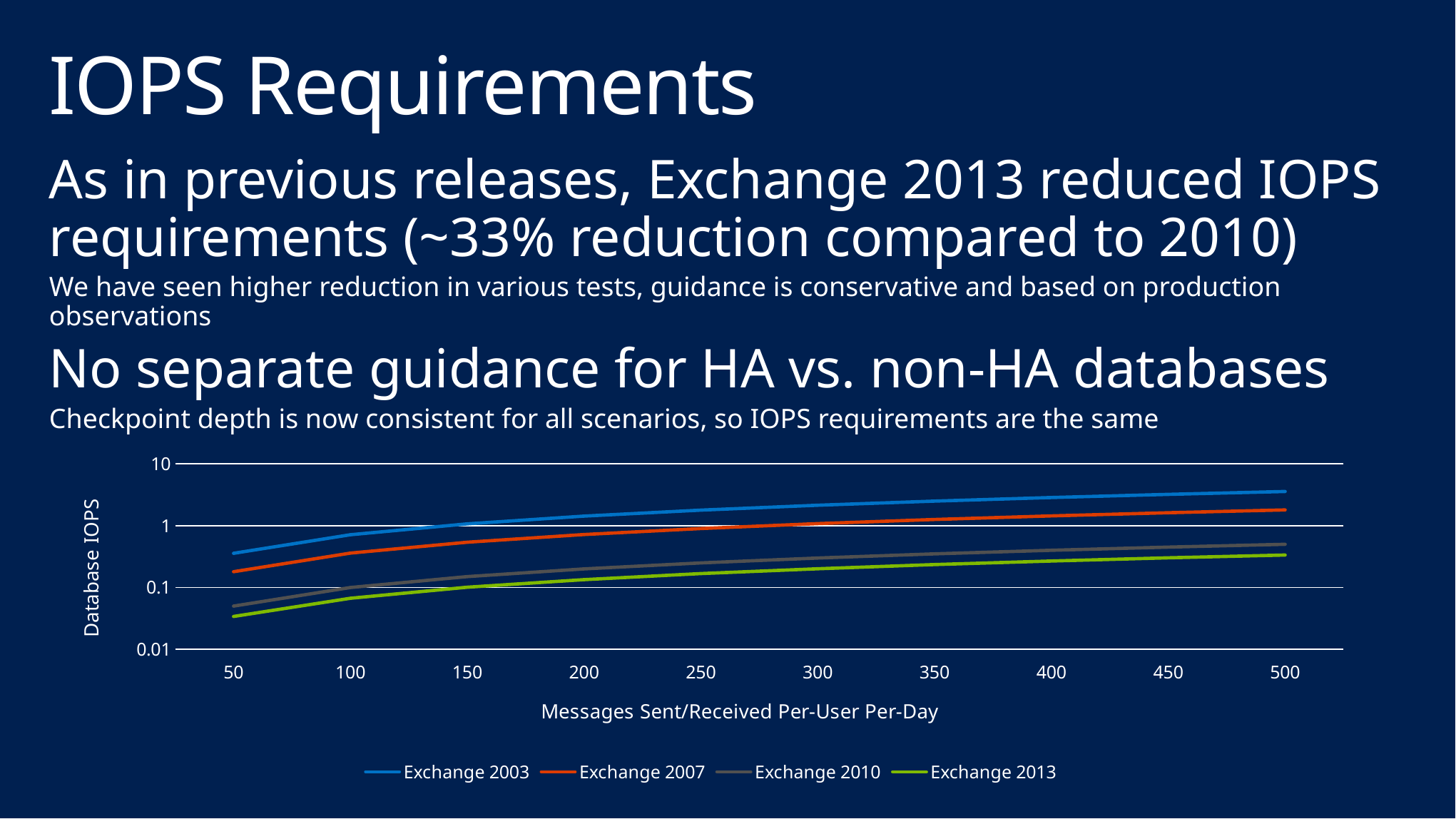
Is the Database IOPS value for Exchange 2013 at 50 messages greater or less than 0.1? less What kind of chart is shown on the slide? Line chart Do the Database IOPS values for Exchange 2013 rise or fall as messages per user per day increase? Rise How many x-axis tick values (message counts) are shown on the chart? 10 Is the Database IOPS value for Exchange 2010 at 500 messages greater or less than 1? less Is the Database IOPS value for Exchange 2003 at 500 messages greater or less than 1? greater What is the label of the chart's x axis? Messages Sent/Received Per-User Per-Day How many series does the chart legend list? 4 What colour is the line for Exchange 2007 in the chart? Orange At 500 messages per user per day, which series has the larger Database IOPS value, Exchange 2003 or Exchange 2013? Exchange 2003 Which series has the lowest Database IOPS across the chart? Exchange 2013 Which series has the highest Database IOPS across the chart? Exchange 2003